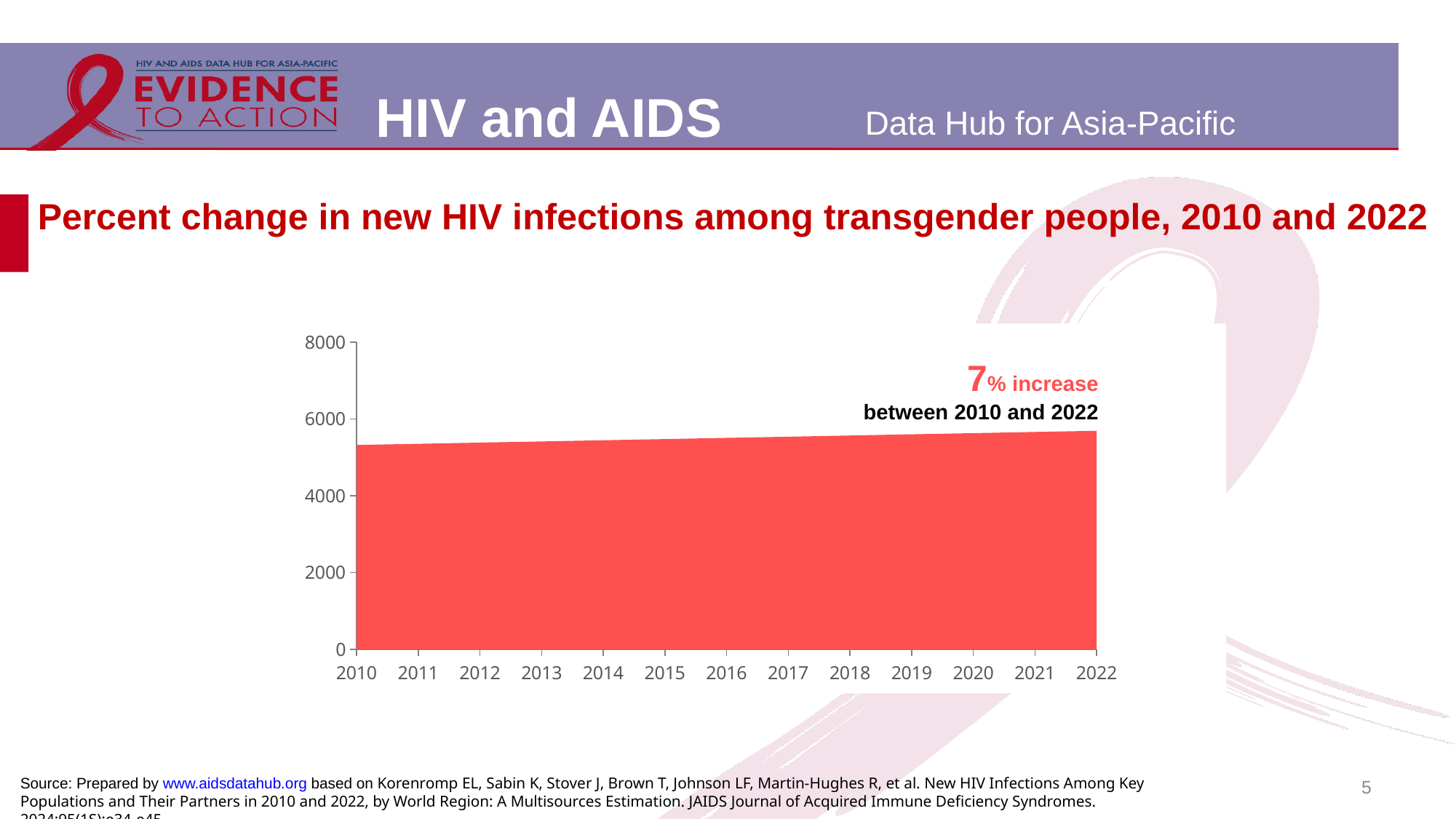
Do the values in the chart rise or fall from 2010 to 2022? rise Which year has the highest value in the chart? 2022 What percent increase between 2010 and 2022 is annotated on the chart? 7% Is the value for 2010 greater or less than 4000? greater What is the highest tick value shown on the y axis of the chart? 8000 Is the value for 2022 greater or less than 6000? less What is the first year shown on the x axis of the chart? 2010 Which year has the higher value, 2010 or 2022? 2022 How many years are shown along the x axis of the chart? 13 What kind of chart is shown on the slide? area chart Which year has the lowest value in the chart? 2010 Is the value for 2016 greater or less than 2000? greater